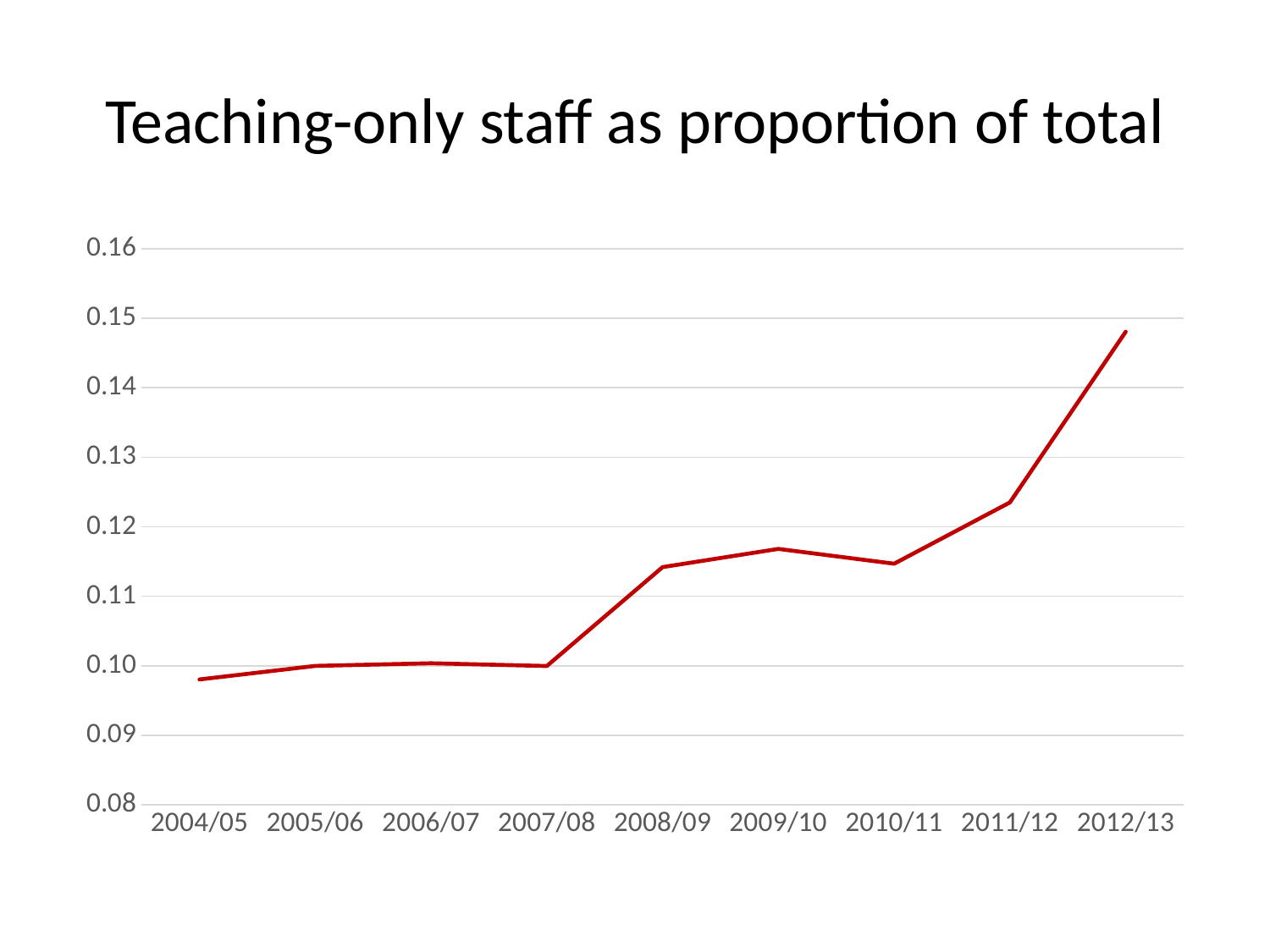
Which is larger, the value for 2006/07 or the value for 2008/09? 2008/09 What kind of chart is shown on the slide? line chart Which year has the lowest proportion of teaching-only staff? 2004/05 Is the value for 2008/09 greater or less than 0.11? greater Is the value for 2012/13 greater or less than 0.14? greater How many academic years are plotted on the x axis? 9 Is the value for 2004/05 greater or less than 0.10? less Overall, does the proportion of teaching-only staff rise or fall from 2004/05 to 2012/13? rise Which year has the highest proportion of teaching-only staff? 2012/13 Which is larger, the value for 2011/12 or the value for 2009/10? 2011/12 What is the title of the chart? Teaching-only staff as proportion of total